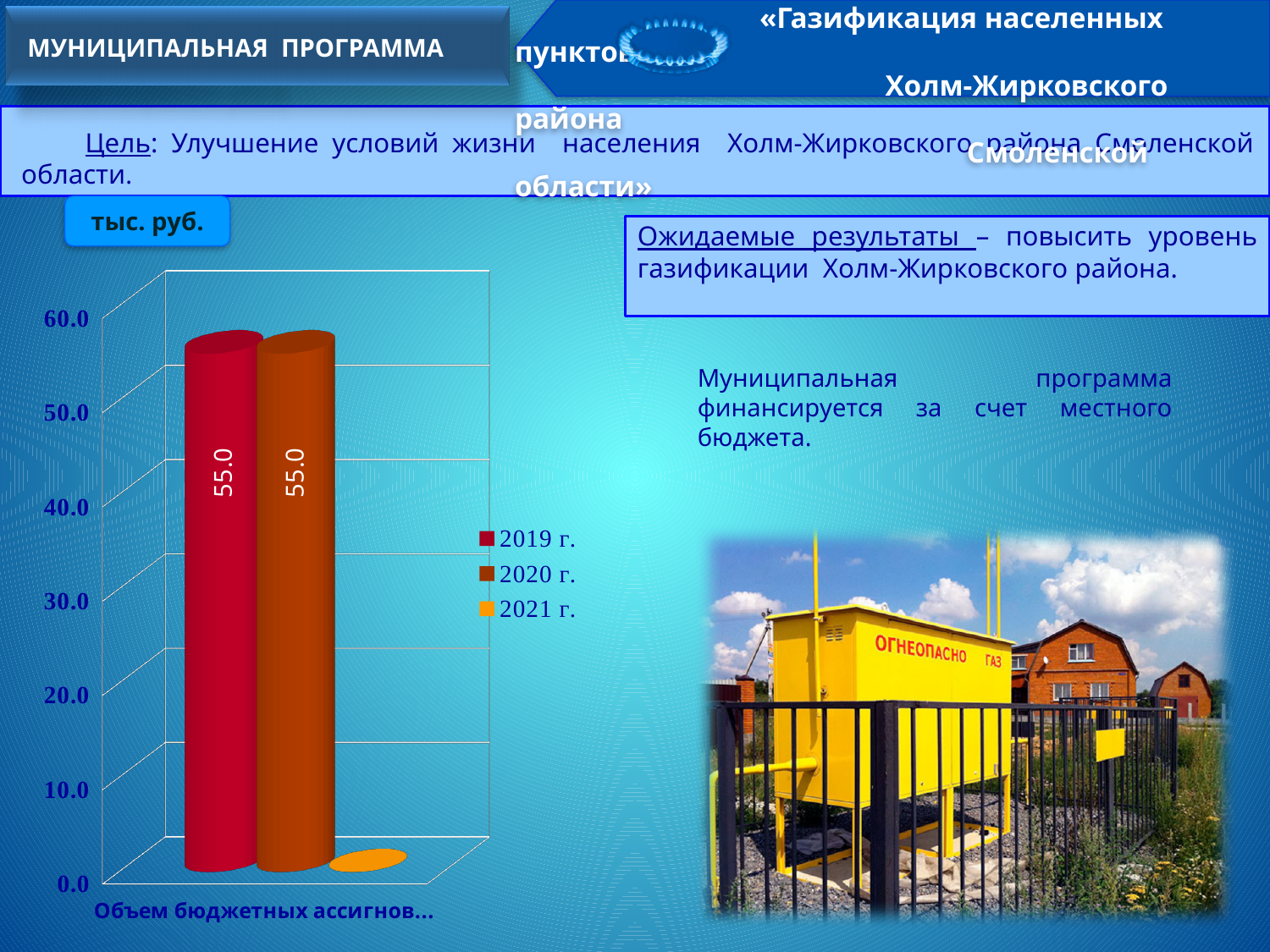
Which is larger, the value for 2019 г. or the value for 2021 г.? 2019 г. What kind of chart is shown on the slide? bar chart What is the value for 2020 г. in the chart? 55.0 How many categories are shown on the x axis of the chart? 1 Is the value for 2021 г. greater or less than 10.0? less What unit of measurement is indicated above the chart? тыс. руб. Is the value for 2020 г. greater or less than 50.0? greater Which series has the lowest value in the chart? 2021 г. How many series does the chart legend list? 3 What is the difference between the values for 2019 г. and 2020 г.? 0.0 What is the value for 2019 г. in the chart? 55.0 What colour represents 2020 г. in the chart legend? brown (dark orange)